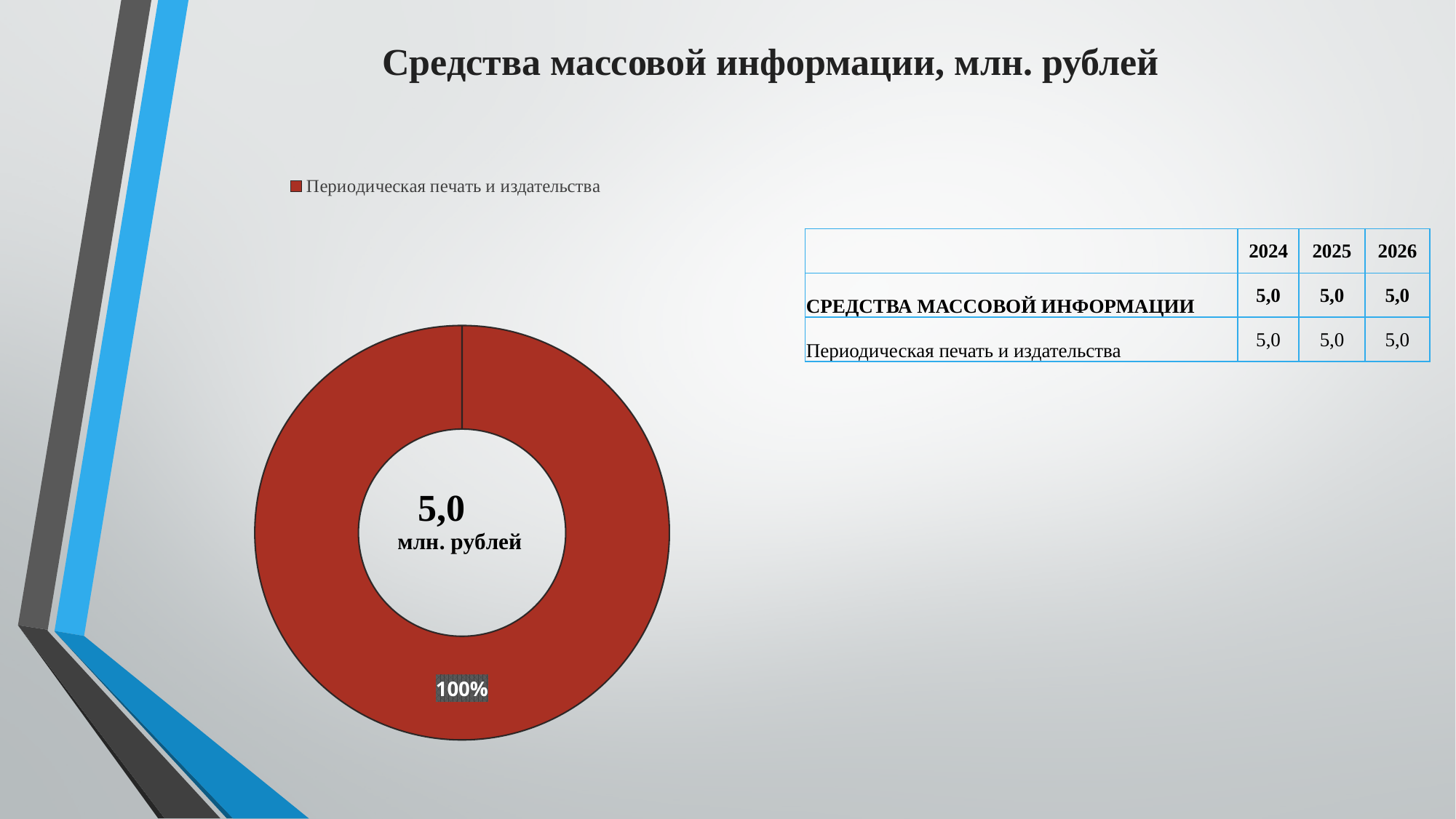
What category is listed in the chart legend? Периодическая печать и издательства What share of the doughnut chart does the slice for Периодическая печать и издательства take? 100% How many entries does the chart legend list? 1 How many slices does the doughnut chart have? 1 What percentage label is printed on the doughnut slice? 100% What kind of chart is shown on the slide? Doughnut chart What value is printed in the centre of the doughnut chart? 5,0 млн. рублей What is the title of the slide above the chart? Средства массовой информации, млн. рублей